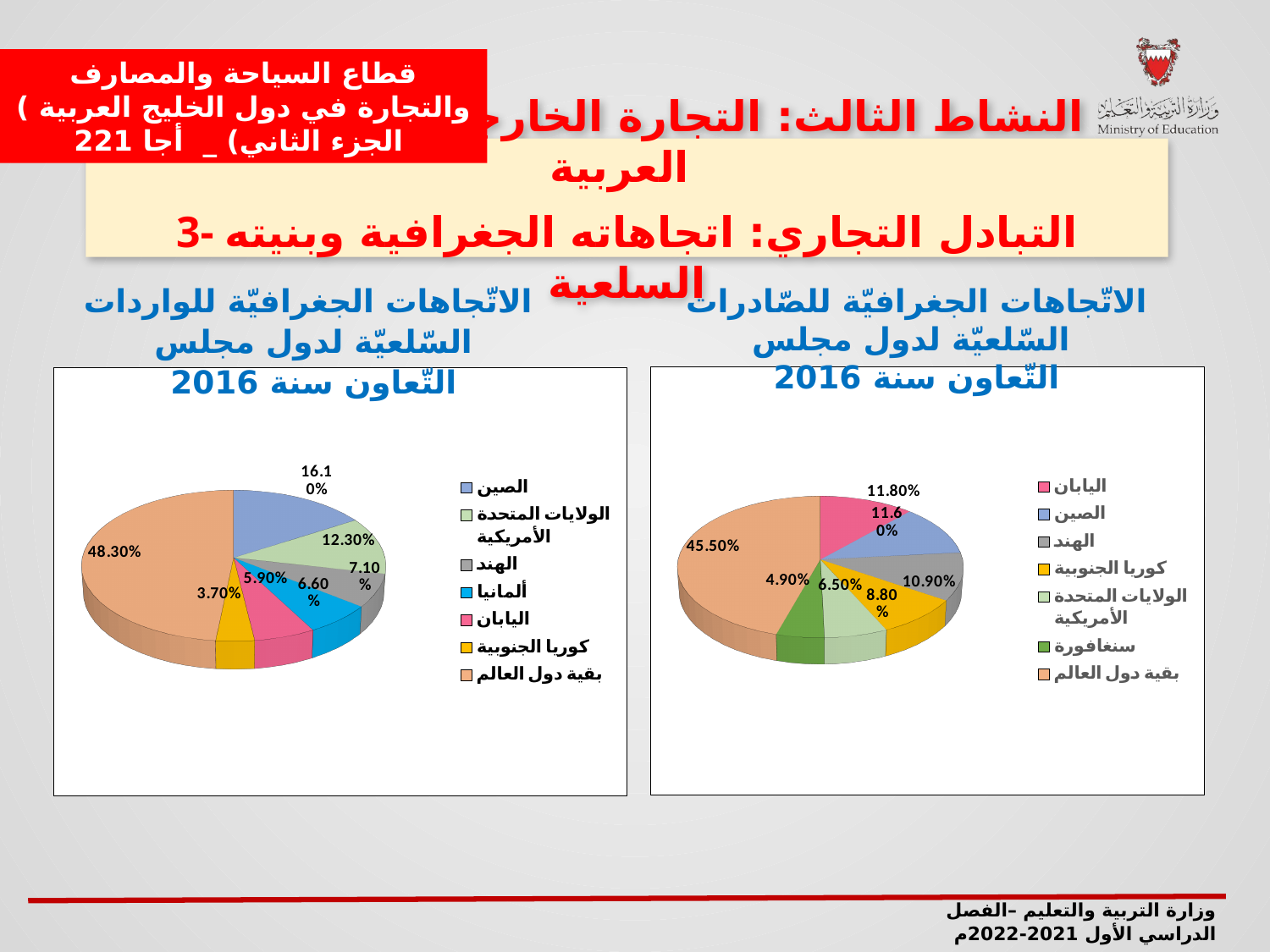
In the right-hand chart (exports of GCC countries in 2016), what share does بقية دول العالم (rest of the world) have? 45.50% In the right-hand chart (exports of GCC countries in 2016), what share does اليابان (Japan) have? 11.80% What type of chart is used on the right-hand chart (exports of GCC countries in 2016)? pie chart In the right-hand chart (exports of GCC countries in 2016), how many slices does the pie have? 7 In the right-hand chart (exports of GCC countries in 2016), what share does سنغافورة (Singapore) have? 4.90% In the left-hand chart (imports of GCC countries in 2016), what share does الصين (China) have? 16.10% How many entries does the legend of the left-hand chart (imports of GCC countries in 2016) list? 7 In the left-hand chart (imports of GCC countries in 2016), what share does كوريا الجنوبية (South Korea) have? 3.70% In the left-hand chart (imports of GCC countries in 2016), which has a larger share, الولايات المتحدة الأمريكية (USA) or الهند (India)? الولايات المتحدة الأمريكية In the right-hand chart (exports of GCC countries in 2016), what is the difference between the shares of الهند (India) and كوريا الجنوبية (South Korea)? 2.10% In the right-hand chart (exports of GCC countries in 2016), which category has the smallest share? سنغافورة In the left-hand chart (imports of GCC countries in 2016), which category has the largest share? بقية دول العالم